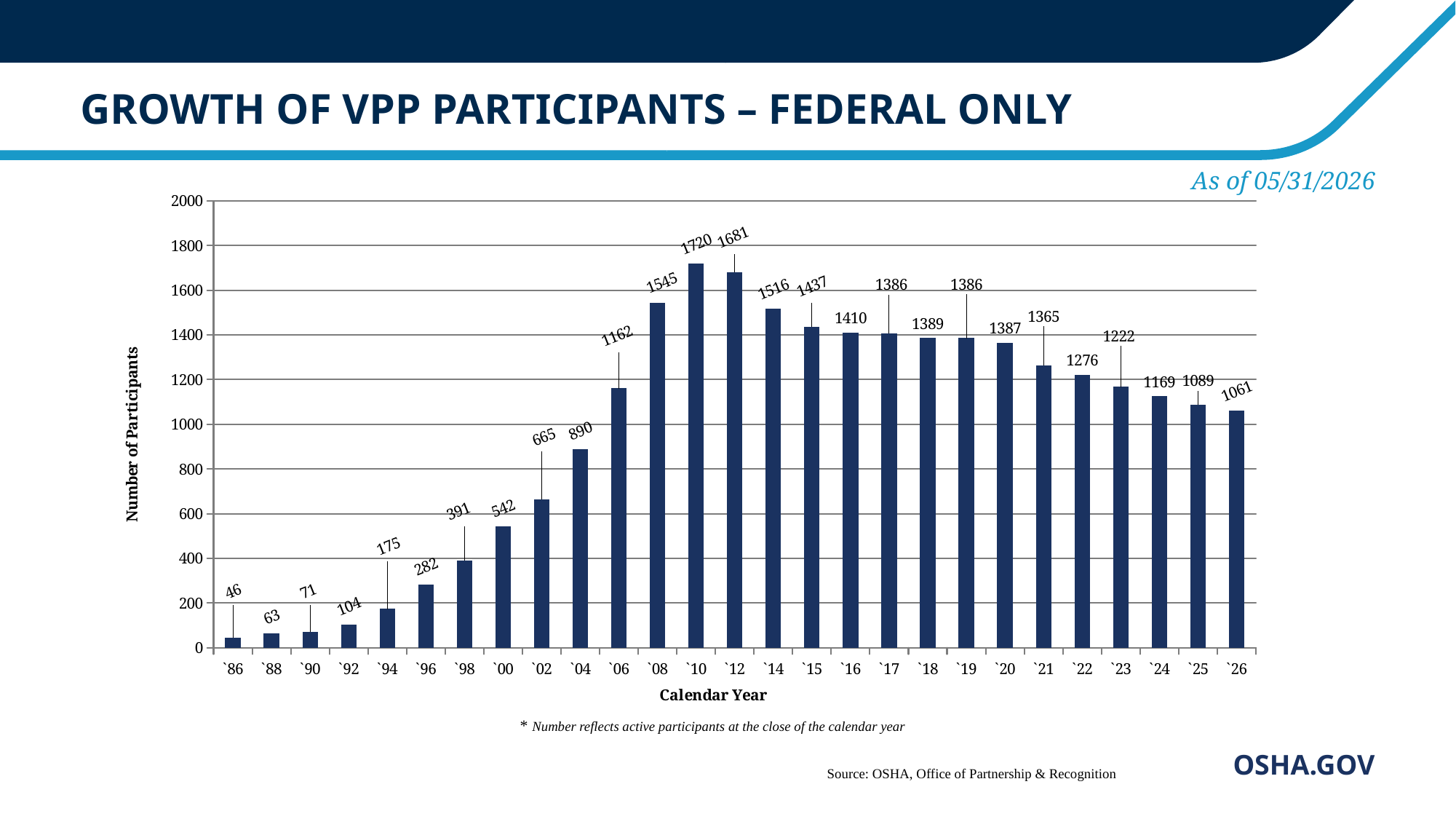
What is the number of participants for `10? 1720 What is the difference in participants between `10 and `12? 39 Is the value for `06 greater or less than 1000? greater What is the number of participants for `94? 175 Do the values rise or fall from `86 to `10? Rise What kind of chart is shown on the slide? Bar chart Which calendar year has the highest number of participants? `10 What is the difference in participants between `25 and `26? 28 Which calendar year has the lowest number of participants? `86 How many calendar years are shown on the x axis? 27 What is the number of participants for `26? 1061 Which year has more participants, `08 or `14? `08